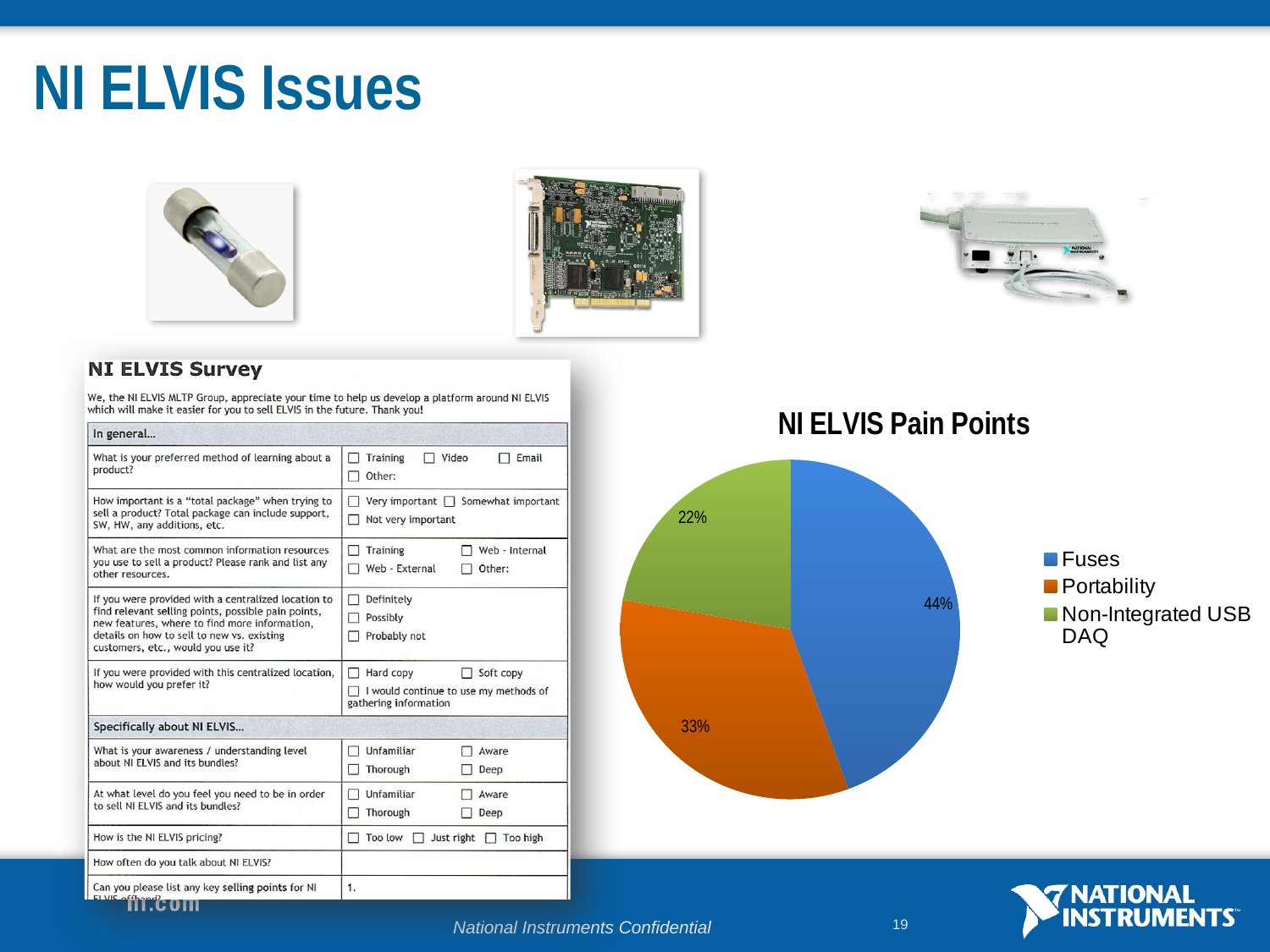
Which category has the smallest slice of the pie? Non-Integrated USB DAQ What share of the pie does Fuses represent? 44% What is the title of the pie chart? NI ELVIS Pain Points What is the difference in percentage points between Fuses and Portability? 11 What share of the pie does Portability represent? 33% How many categories does the pie chart show? 3 What share of the pie does Non-Integrated USB DAQ represent? 22% Which is larger, the slice for Portability or the slice for Non-Integrated USB DAQ? Portability What is the difference in percentage points between Portability and Non-Integrated USB DAQ? 11 Which category has the largest slice of the pie? Fuses Which colour represents Portability in the pie chart? orange What type of chart is shown on the slide? pie chart